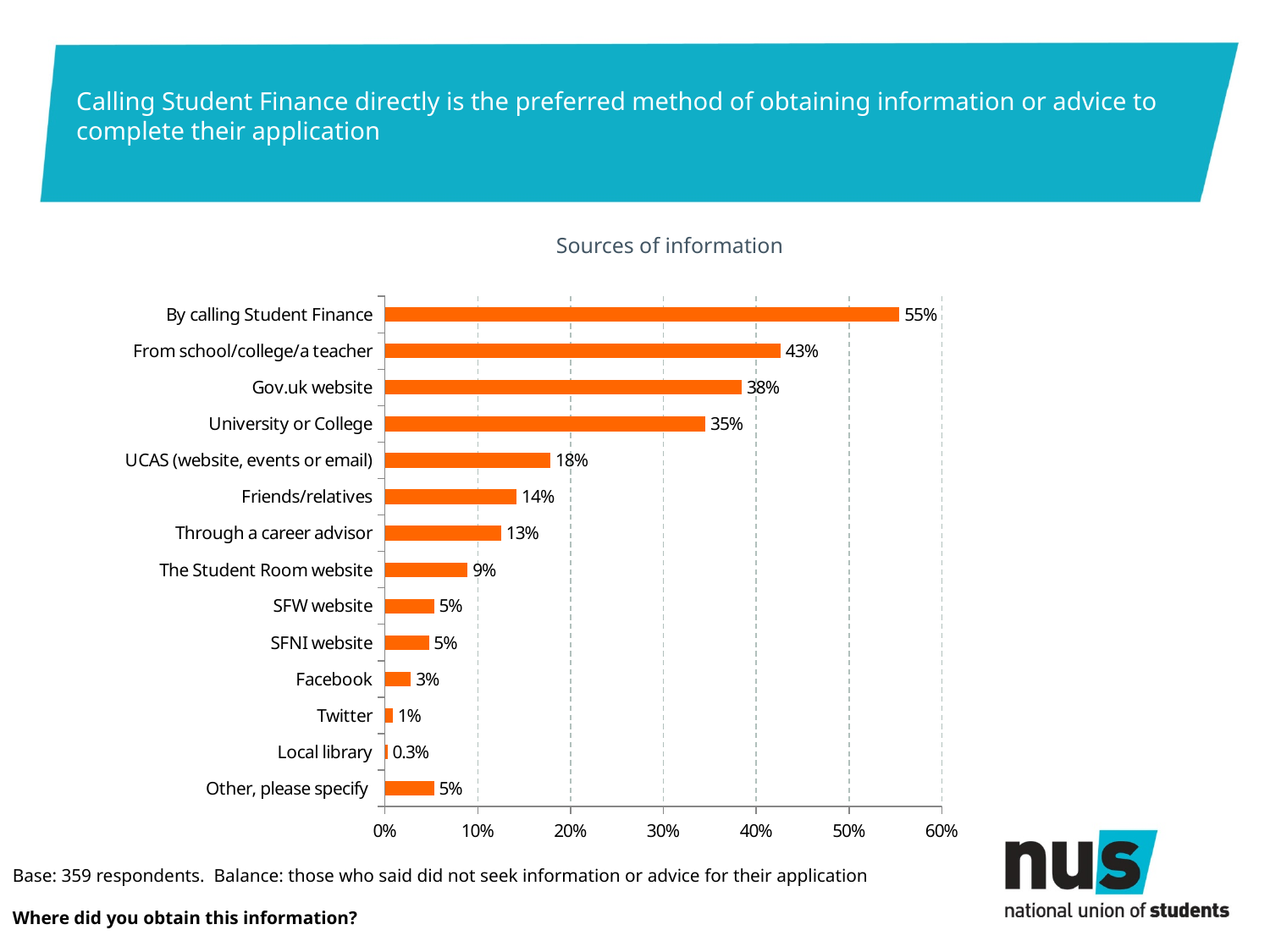
What percentage of respondents used the Local library as a source of information? 0.3% Is the value for University or College greater or less than 30%? greater What is the title of the chart? Sources of information How many sources of information are listed in the chart? 14 What percentage of respondents obtained information by calling Student Finance? 55% What is the difference in percentage points between Facebook and Twitter? 2 Which source of information has the highest percentage? By calling Student Finance What is the value for the Gov.uk website? 38% What is the difference in percentage points between 'By calling Student Finance' and 'From school/college/a teacher'? 12 Which source of information has the lowest percentage? Local library Which has a higher value: UCAS (website, events or email) or Friends/relatives? UCAS (website, events or email) What type of chart is shown on the slide? Bar chart